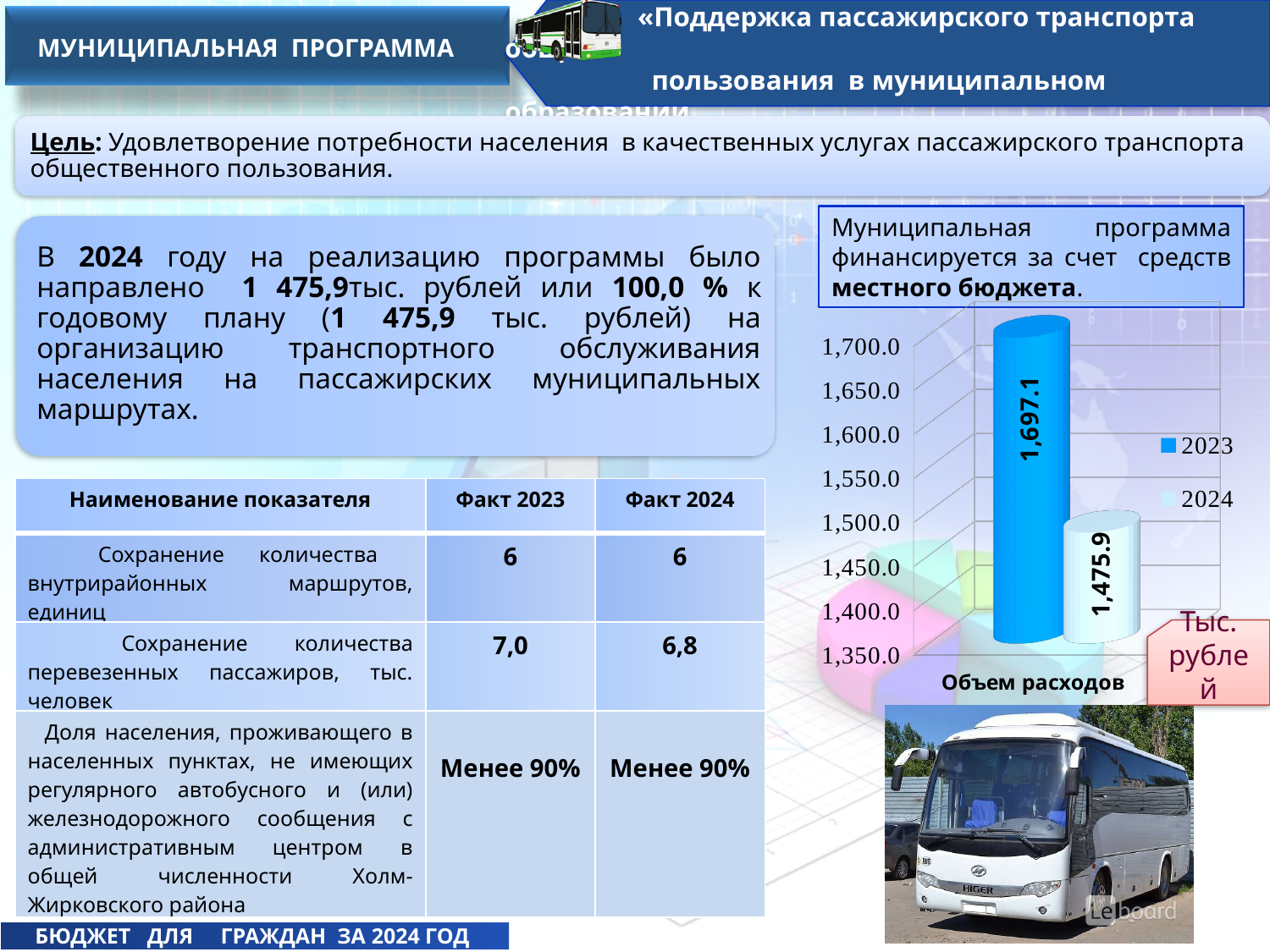
Is the value for 2024 greater or less than 1,500.0? less What is the category label shown below the bars in the chart? Объем расходов What kind of chart is shown on the slide? bar chart What is the value for 2023 in the chart? 1,697.1 Which series has the lowest value in the chart? 2024 What is the highest value shown on the chart's vertical axis? 1,700.0 What is the difference between the 2023 and 2024 values in the chart? 221.2 How many series does the chart legend list? 2 Which year has the higher value in the chart, 2023 or 2024? 2023 Do the values fall or rise from 2023 to 2024 in the chart? fall What is the value for 2024 in the chart? 1,475.9 Is the value for 2023 greater or less than 1,650.0? greater